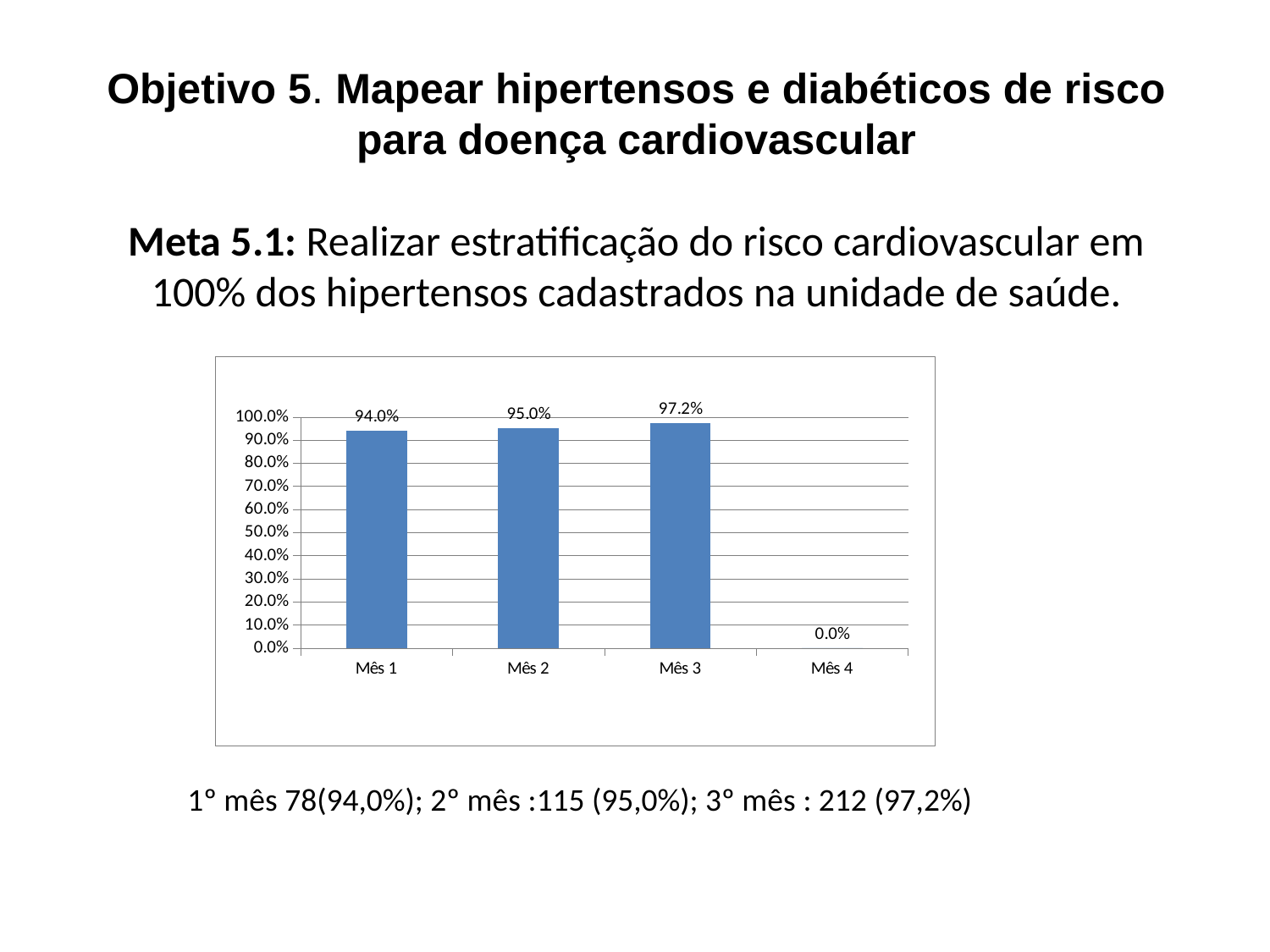
What is the value for Mês 2? 95.0% What is the value for Mês 1? 94.0% How many categories are shown on the x axis? 4 Do the values rise or fall from Mês 1 to Mês 3? rise Which category has the highest value? Mês 3 What is the value for Mês 4? 0.0% What is the difference between the values for Mês 2 and Mês 1? 1.0% What is the value for Mês 3? 97.2% What kind of chart is shown on the slide? bar chart Which category has the lowest value? Mês 4 What is the difference between the values for Mês 3 and Mês 1? 3.2% Which is larger, the value for Mês 3 or the value for Mês 2? Mês 3